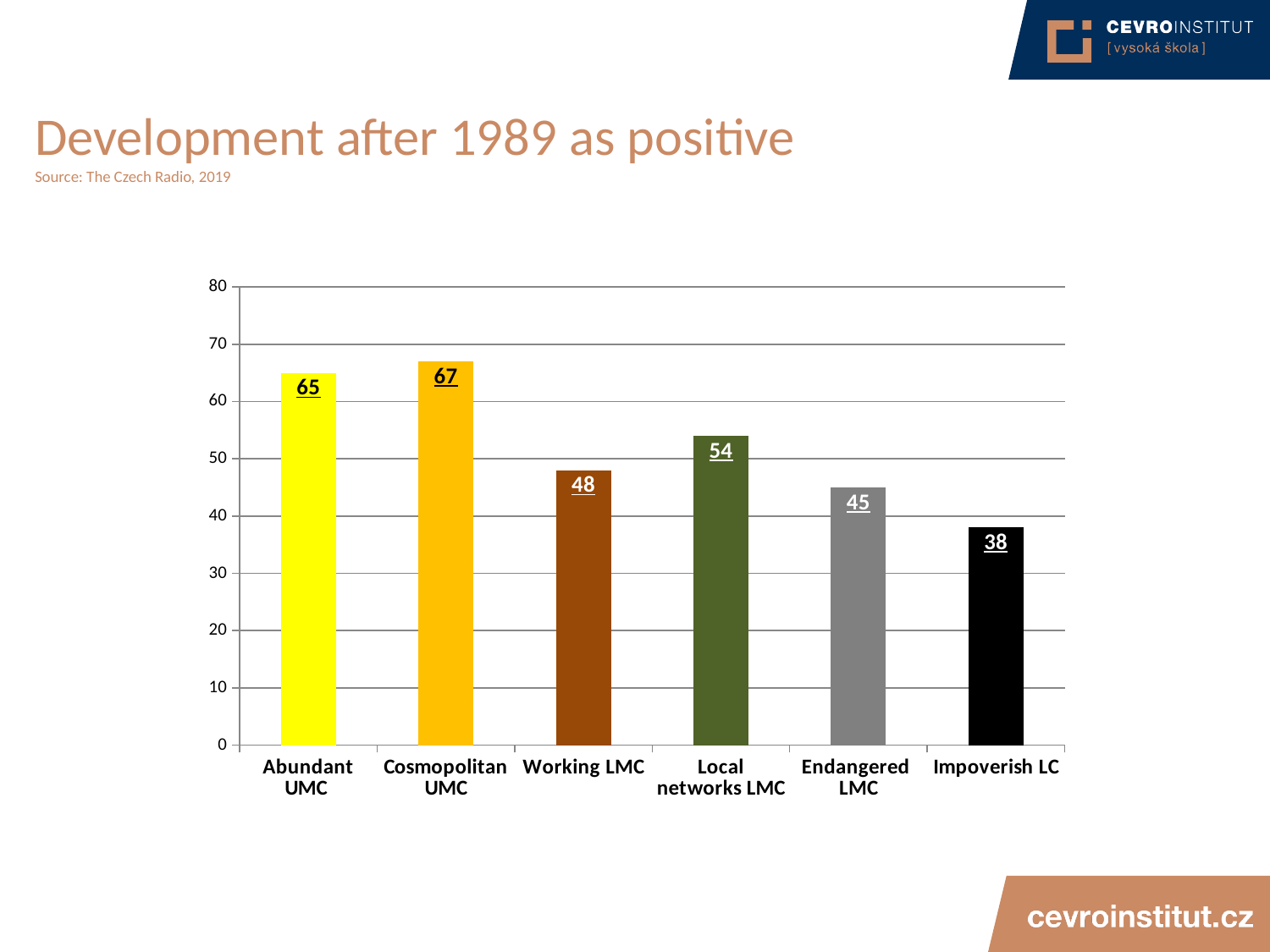
What is the value for Abundant UMC? 65 Is the value for Endangered LMC greater or less than 50? less Which is larger, the value for Local networks LMC or the value for Endangered LMC? Local networks LMC What is the title of the slide? Development after 1989 as positive What kind of chart is shown on the slide? bar chart What is the difference between the values for Cosmopolitan UMC and Working LMC? 19 What colour is the bar for Working LMC? brown Which category has the lowest value? Impoverish LC How many categories are shown on the x axis? 6 Which category has the highest value? Cosmopolitan UMC What is the value for Local networks LMC? 54 What is the value for Impoverish LC? 38